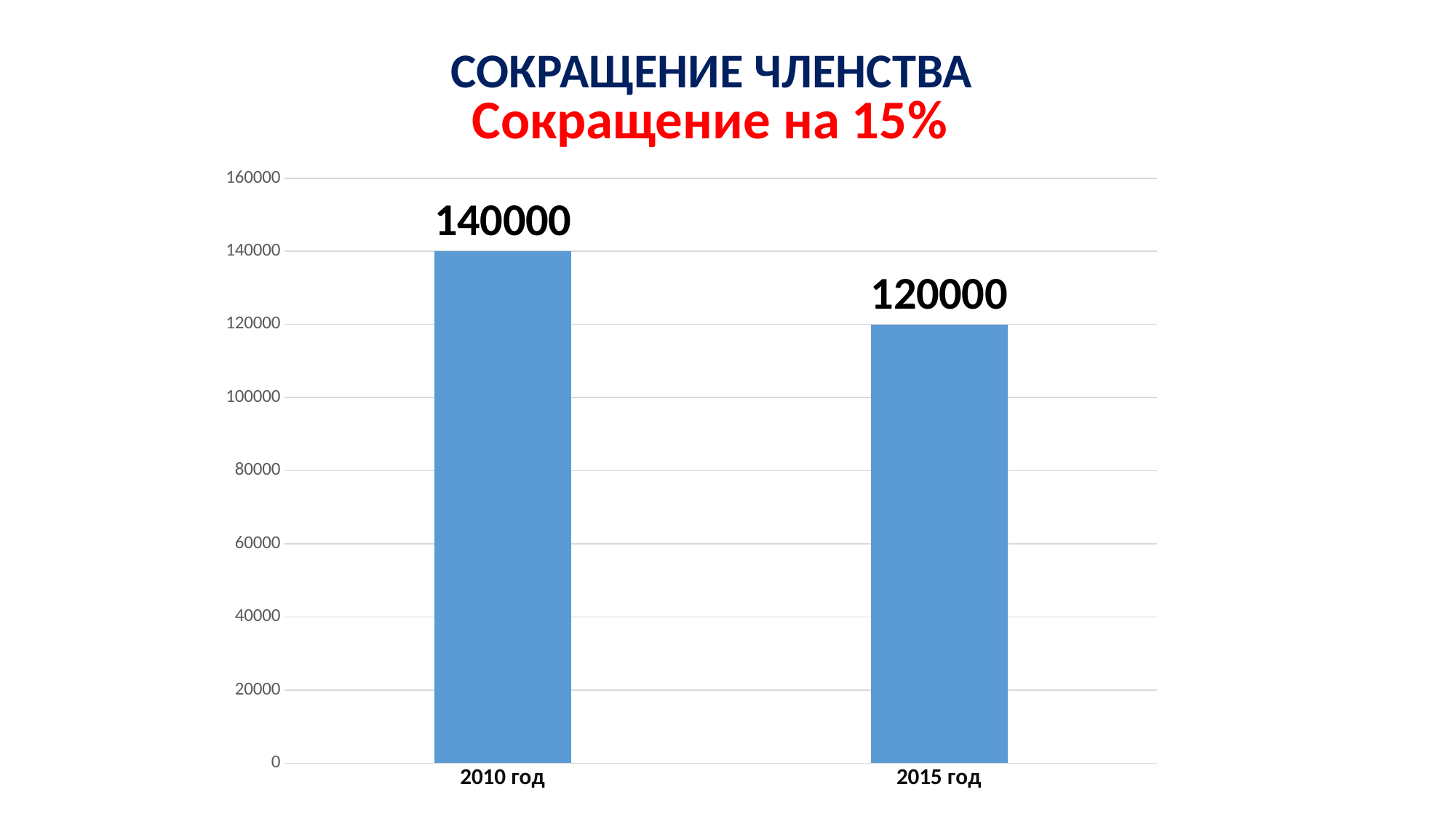
Do the values rise or fall from 2010 год to 2015 год? fall Which category has the lowest value? 2015 год What kind of chart is shown on the slide? bar chart Is the value for 2015 год greater or less than 100000? greater Which is larger, the value for 2010 год or the value for 2015 год? 2010 год Is the value for 2010 год greater or less than 160000? less What is the difference between the values for 2010 год and 2015 год? 20000 What is the value for 2015 год? 120000 What is the value for 2010 год? 140000 How many categories are shown on the x axis? 2 Which category has the highest value? 2010 год What is the title of the chart? СОКРАЩЕНИЕ ЧЛЕНСТВА